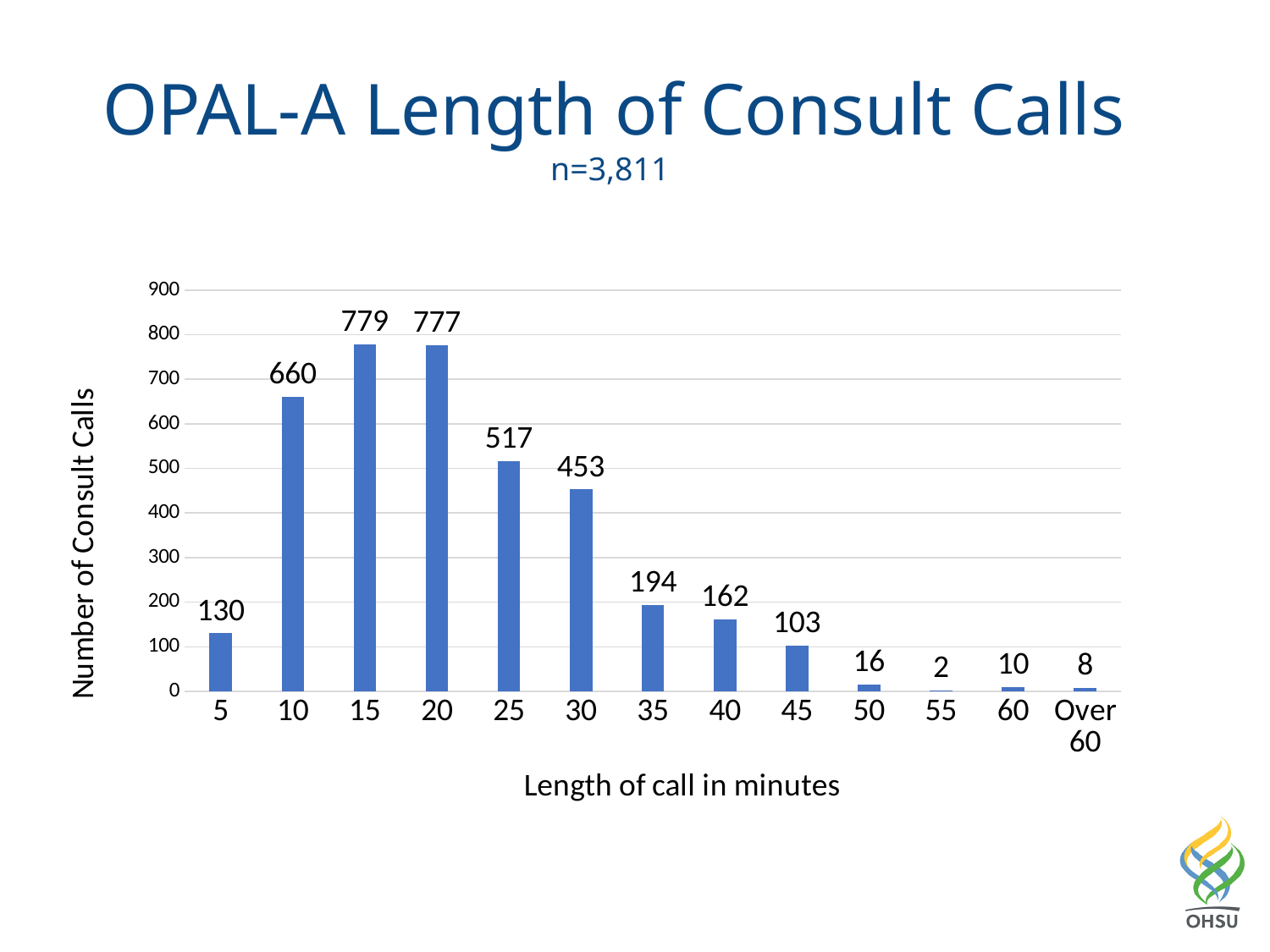
What is the difference between the number of consult calls at 10 minutes and at 5 minutes? 530 Which call length category has the lowest number of consult calls? 55 How many consult calls lasted 15 minutes? 779 What is the number of consult calls for the 30-minute category? 453 Which call length category has the highest number of consult calls? 15 What is the label of the y axis? Number of Consult Calls What kind of chart is shown on the slide? Bar chart How many consult calls are shown for the 'Over 60' category? 8 How many call length categories are shown on the x axis? 13 Do the values rise or fall from the 20-minute category to the 45-minute category? Fall What sample size (n) is stated in the chart's subtitle? n=3,811 Which has more consult calls: the 35-minute category or the 40-minute category? 35